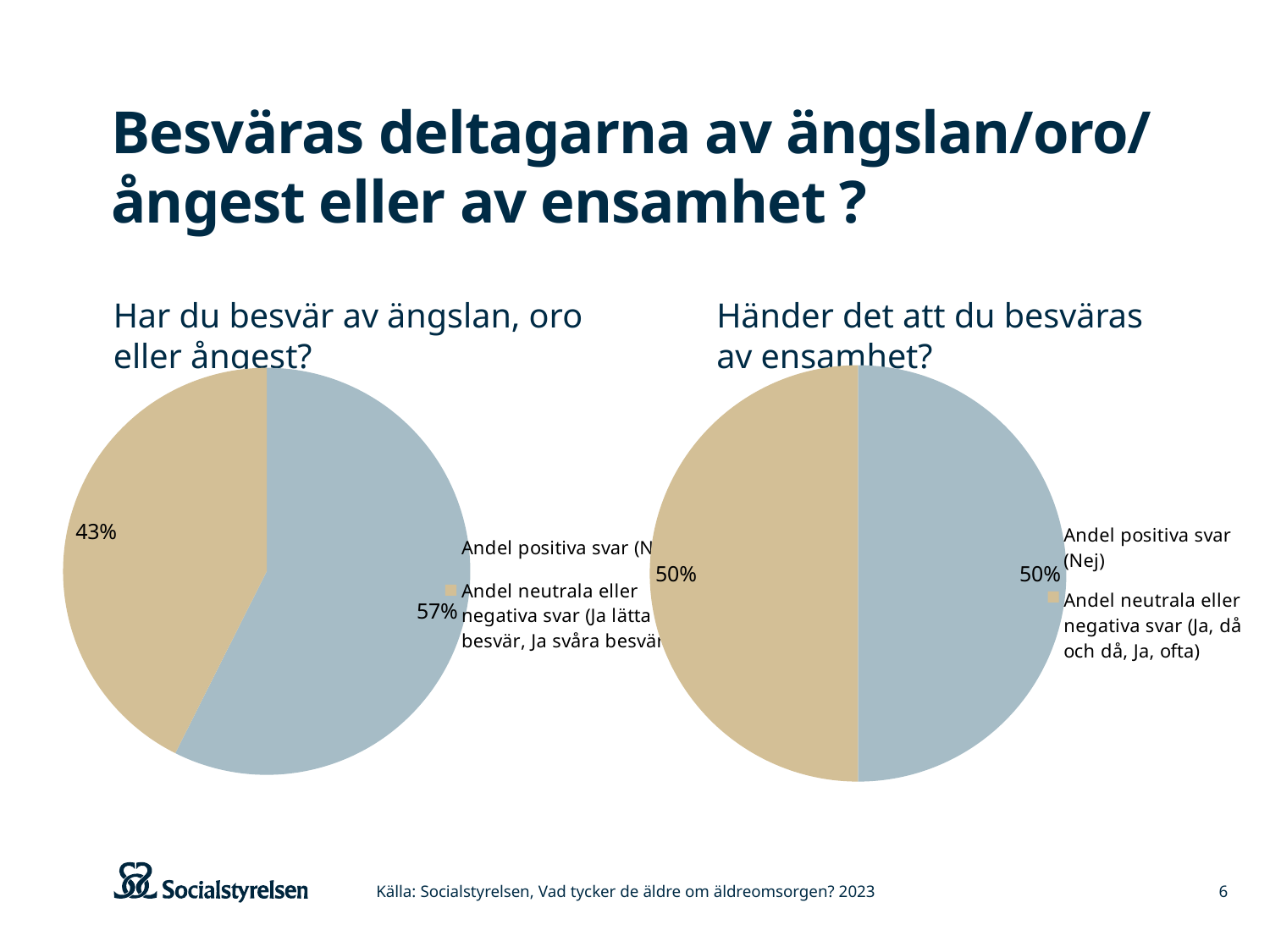
In the left pie chart (Har du besvär av ängslan, oro eller ångest?), which category has the smallest slice? Andel neutrala eller negativa svar In the right pie chart (Händer det att du besväras av ensamhet?), what share of answers are positive (Nej)? 50% In the right pie chart (Händer det att du besväras av ensamhet?), what share of answers are neutral or negative (Ja, då och då, Ja, ofta)? 50% In the left pie chart (Har du besvär av ängslan, oro eller ångest?), which category has the largest slice? Andel positiva svar (Nej) What type of chart is used on this slide? Pie chart In the left pie chart (Har du besvär av ängslan, oro eller ångest?), what share of answers are positive (Nej)? 57% How many entries does the legend of the right pie chart (Händer det att du besväras av ensamhet?) list? 2 In the left pie chart (Har du besvär av ängslan, oro eller ångest?), what is the difference in percentage points between the positive and the neutral/negative slices? 14 percentage points In the left pie chart (Har du besvär av ängslan, oro eller ångest?), which is larger: the positive slice or the neutral/negative slice? The positive slice (57%) How many pie charts are shown on the slide? 2 In the left pie chart (Har du besvär av ängslan, oro eller ångest?), what share of answers are neutral or negative? 43% How many slices does the right pie chart (Händer det att du besväras av ensamhet?) have? 2